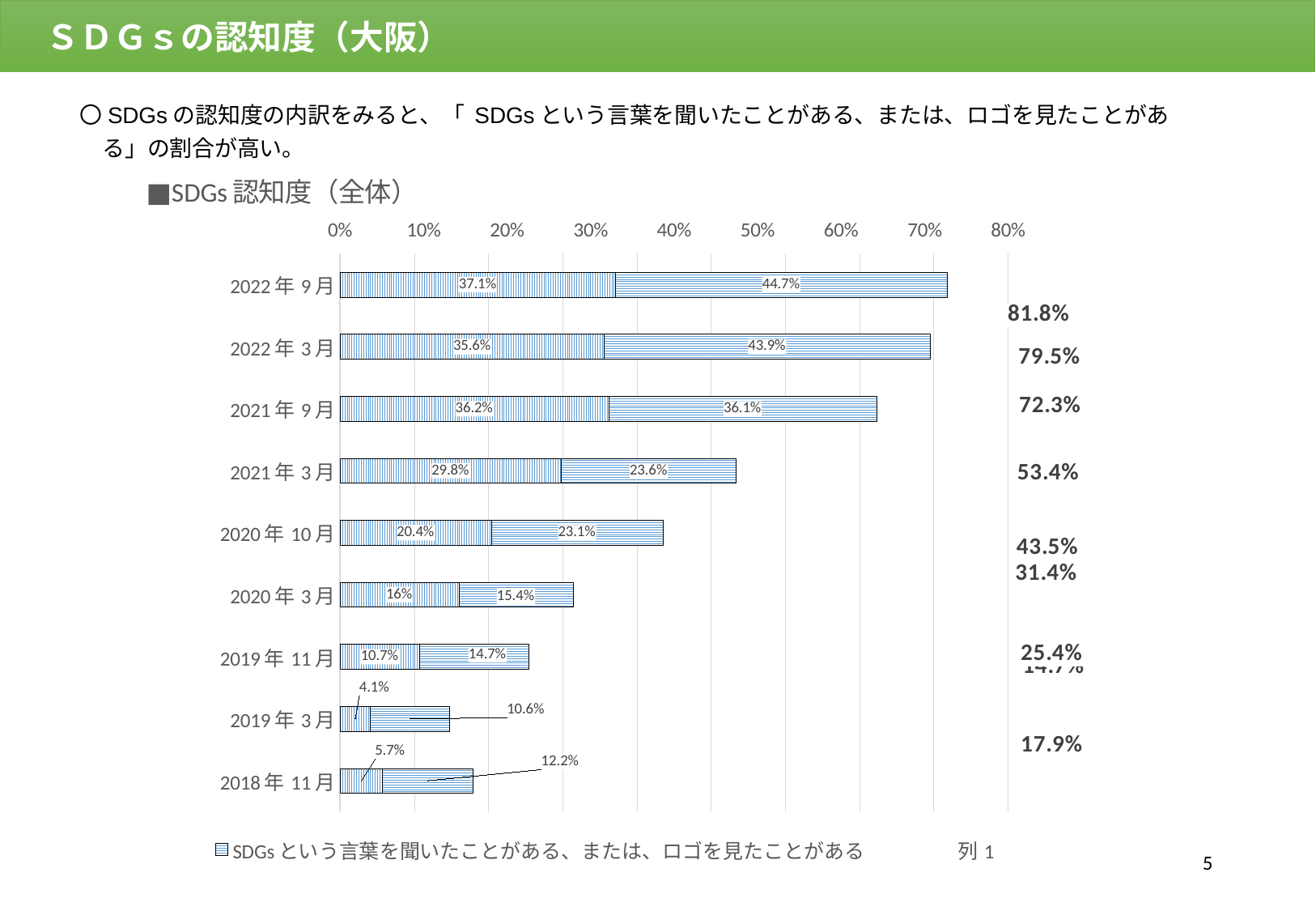
Which time period has the highest total bar? 2022年9月 What kind of chart is shown on the slide? Stacked bar chart What is the total of the stacked bar for 2021年9月? 72.3% How many series does the legend list? 2 What is the value of the first segment for 2019年3月? 4.1% What is the value of the 列1 segment for 2021年3月? 53.4% Which time period has the lowest value for the first segment (SDGsという言葉を聞いたことがある、または、ロゴを見たことがある)? 2019年3月 How many time periods (categories) are plotted on the chart? 9 Which is larger: the first segment for 2020年10月 or the first segment for 2020年3月? 2020年10月 What is the difference between the 列1 values for 2022年9月 and 2022年3月? 2.3% Is the total bar for 2021年3月 greater or less than 50%? greater